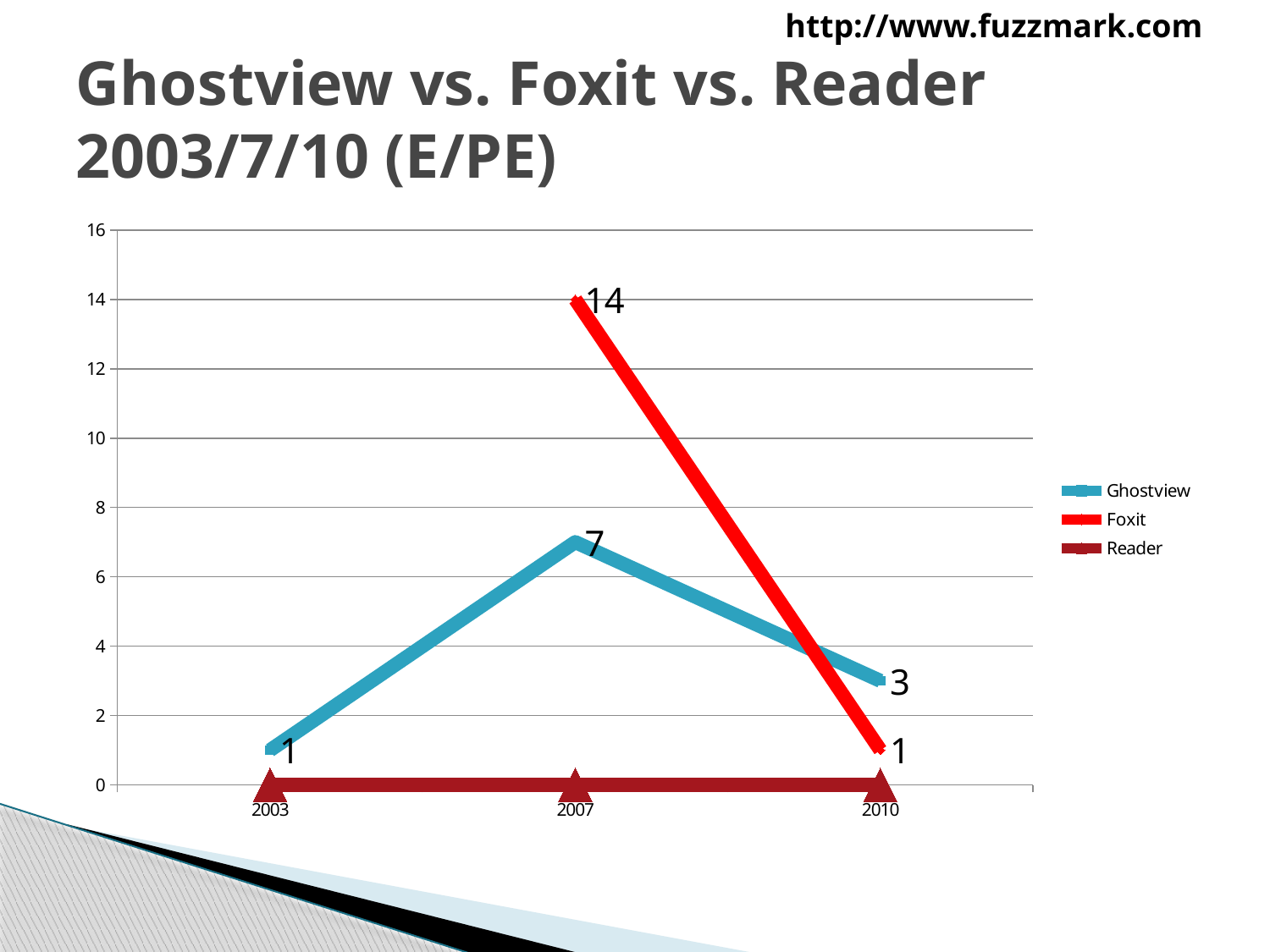
Which is larger in 2010, Ghostview or Foxit? Ghostview Does the Foxit value rise or fall from 2007 to 2010? fall What is the value for Foxit in 2007? 14 What is the value for Ghostview in 2003? 1 What is the value for Foxit in 2010? 1 What is the value for Ghostview in 2010? 3 In which year is the Ghostview value highest? 2007 How many series does the legend list? 3 What is the difference between the Foxit and Ghostview values in 2007? 7 What is the value for Ghostview in 2007? 7 What type of chart is shown on the slide? line chart How many years are shown on the x axis? 3